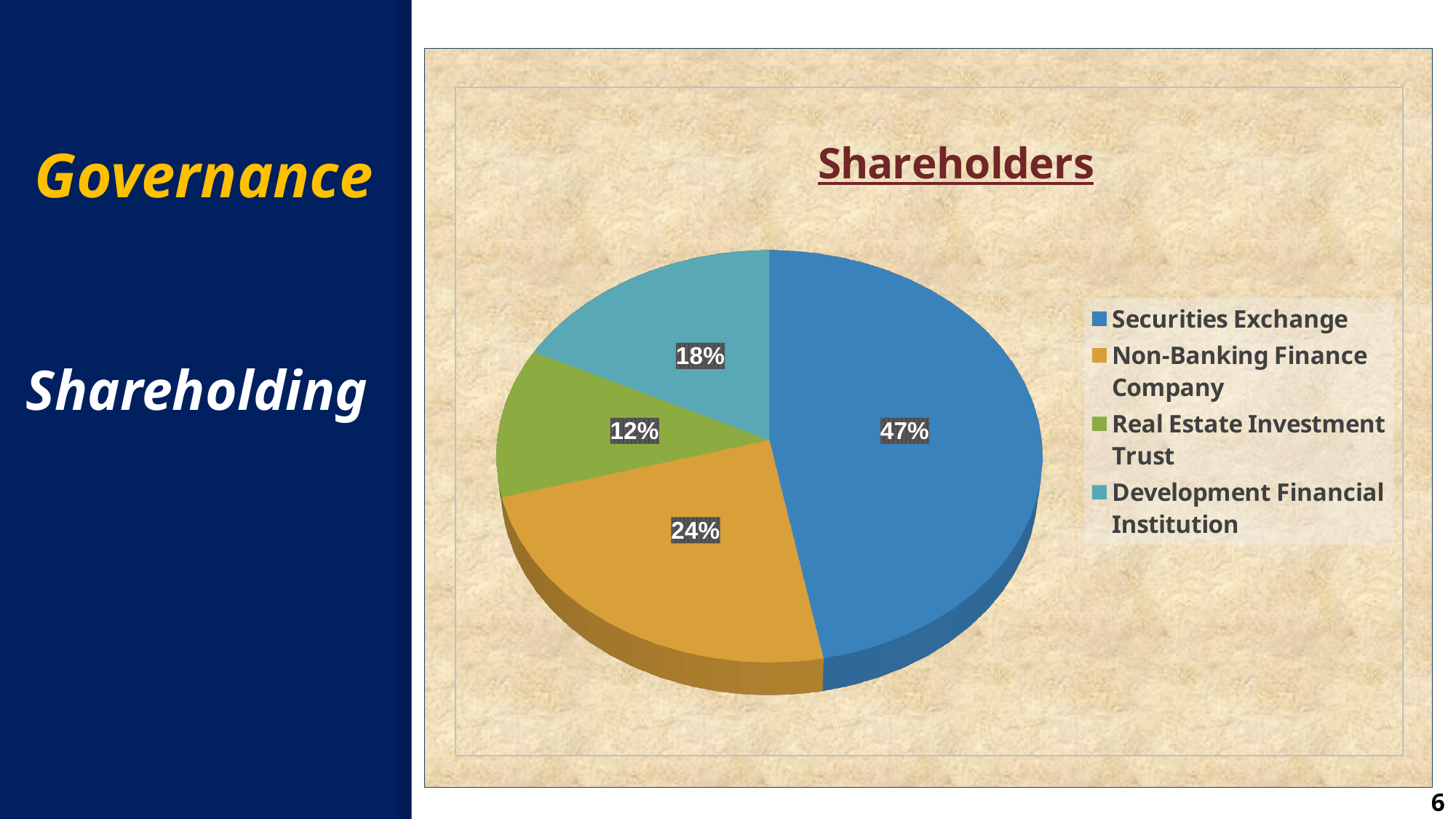
What share of the pie does Development Financial Institution hold? 18% How many shareholder categories are shown in the pie chart? 4 What is the title of the chart? Shareholders Which is larger, the share for Development Financial Institution or the share for Real Estate Investment Trust? Development Financial Institution What is the difference in percentage points between Securities Exchange and Non-Banking Finance Company? 23 What share of the pie does Securities Exchange hold? 47% Which shareholder category has the largest slice? Securities Exchange What share of the pie does Non-Banking Finance Company hold? 24% What share of the pie does Real Estate Investment Trust hold? 12% What colour is the slice for Non-Banking Finance Company? orange What kind of chart is shown on the slide? pie chart Which shareholder category has the smallest slice? Real Estate Investment Trust